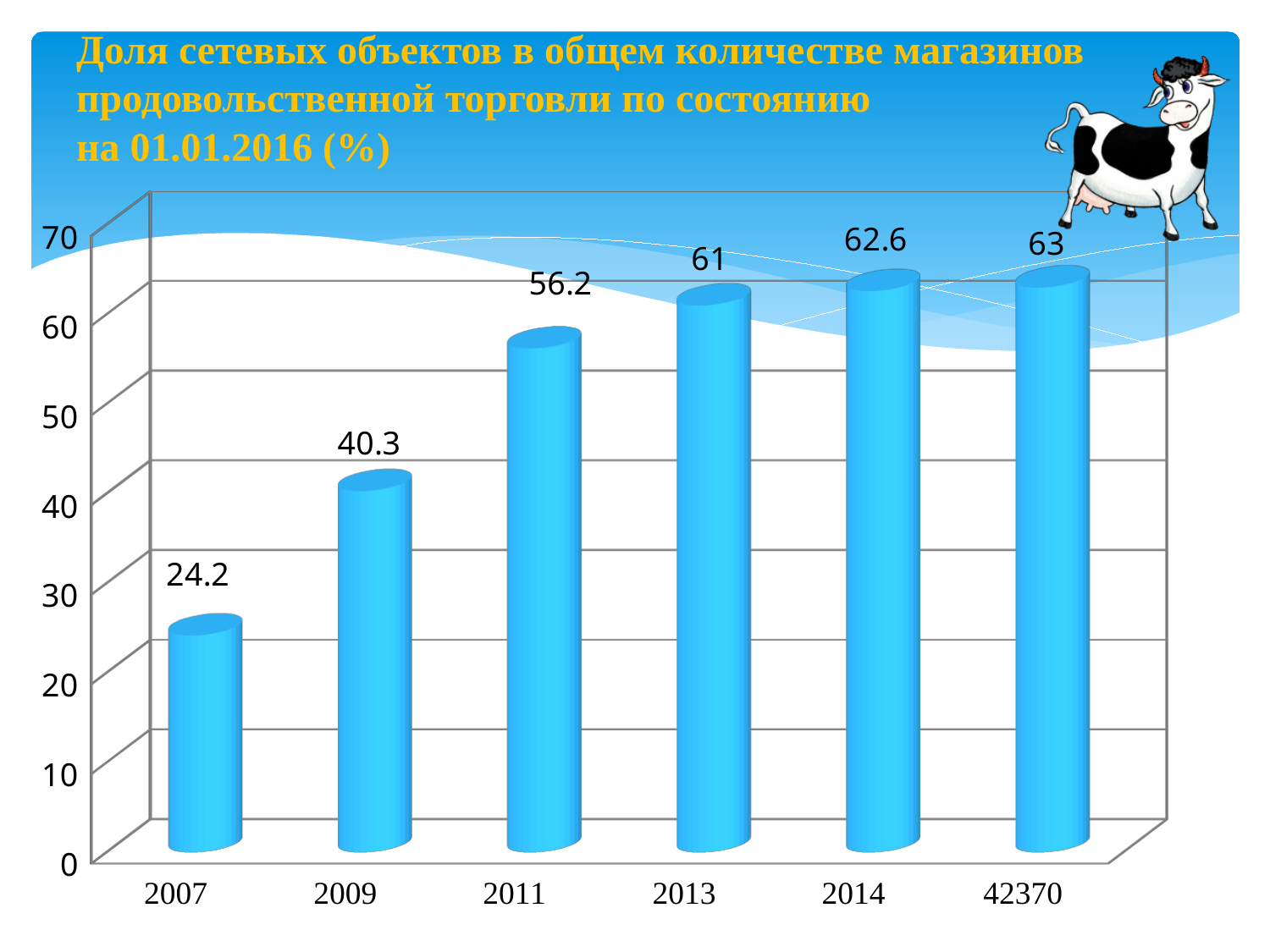
What is the value for 2007? 24.2 Which category has the highest value? 42370 What is the difference between the values for 2009 and 2007? 16.1 What is the value for 2011? 56.2 Which is larger, the value for 2009 or the value for 2011? 2011 What is the value for 2014? 62.6 What is the value for the category labelled 42370? 63 How many bars are shown in the chart? 6 What is the difference between the values for 2013 and 2011? 4.8 Do the values rise or fall from left to right along the x axis? rise What kind of chart is shown on the slide? bar chart Which category has the lowest value? 2007